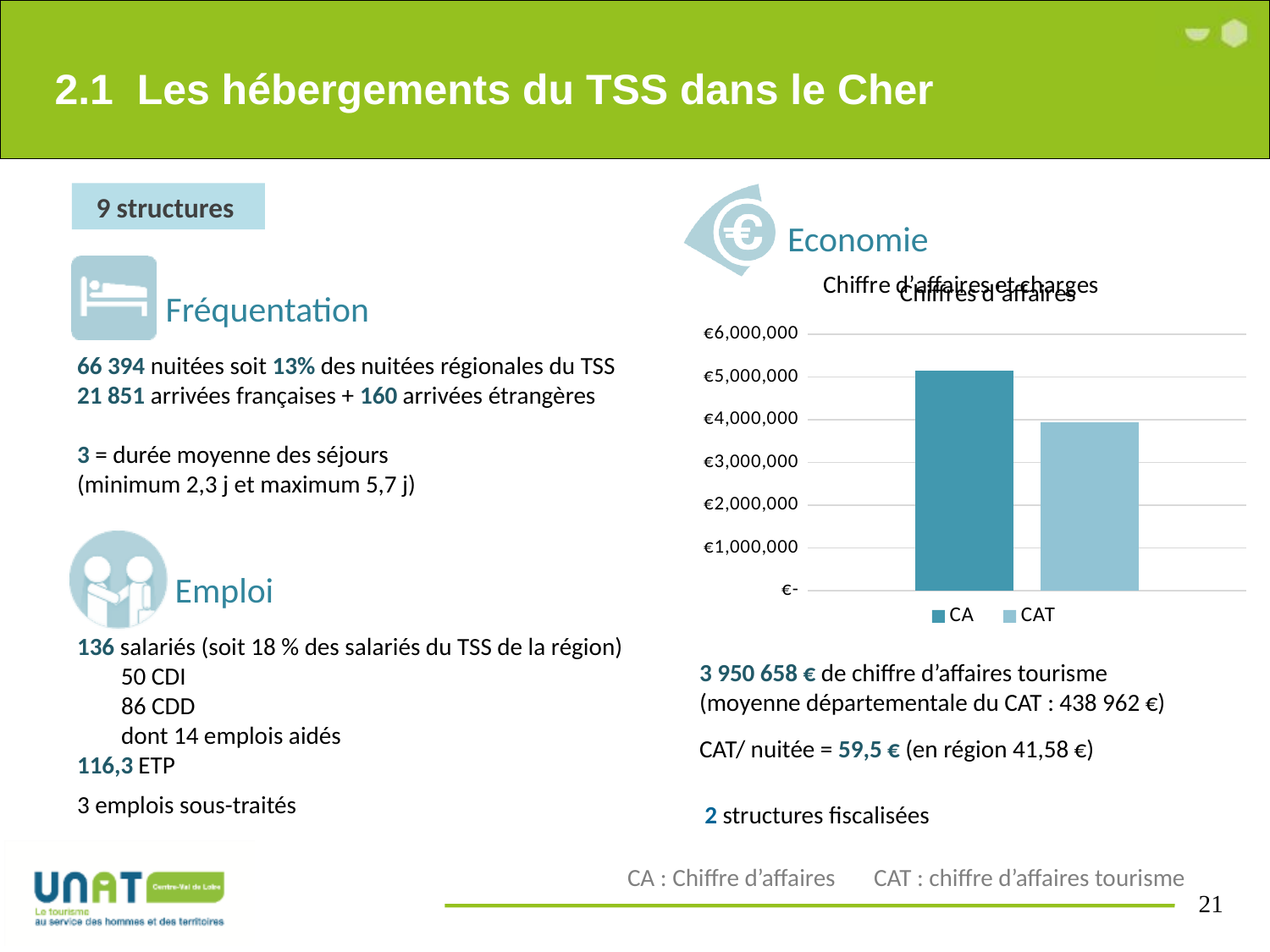
What is the highest tick value shown on the chart's vertical axis? €6,000,000 What are the two entries in the chart legend? CA and CAT How many bars are plotted in the chart? 2 Which bar is the lowest in the chart? CAT Which bar is the highest in the chart? CA Is the value for CA greater or less than €6,000,000? less Which is larger in the chart, CA or CAT? CA Is the value for CA greater or less than €5,000,000? greater How many series does the chart legend list? 2 What kind of chart is shown on the slide? bar chart Is the value for CAT greater or less than €3,000,000? greater